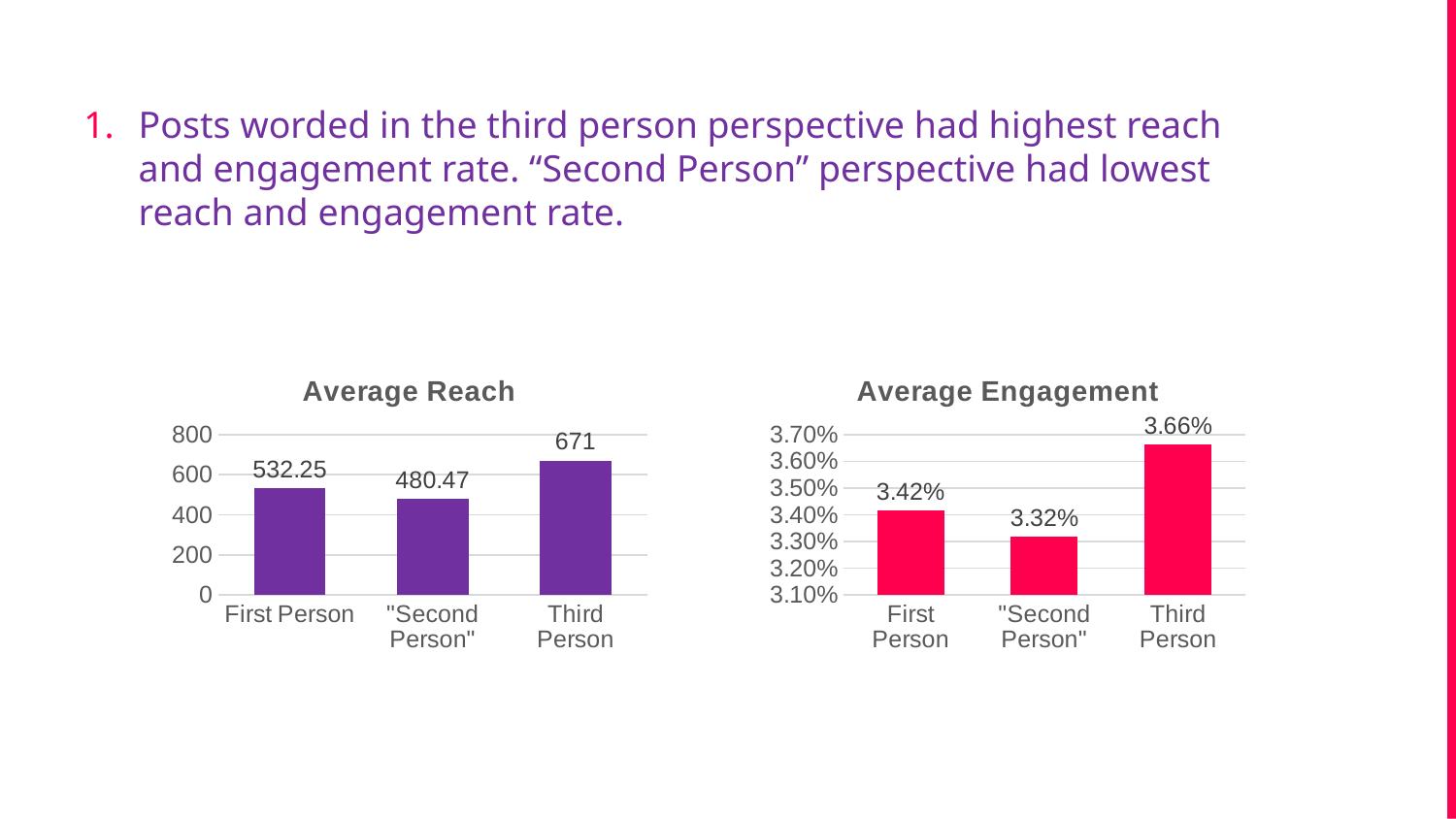
In the Average Engagement chart, what is the value for Third Person? 3.66% In the Average Reach chart, what is the difference between the Third Person and "Second Person" values? 190.53 In the Average Engagement chart, which category has the highest value? Third Person In the Average Engagement chart, what is the difference between the First Person and "Second Person" values? 0.10% In the Average Reach chart, what is the value for First Person? 532.25 How many categories are shown in the Average Engagement chart? 3 In the Average Reach chart, which category has the lowest value? "Second Person" In the Average Reach chart, which is larger, the value for First Person or the value for "Second Person"? First Person What colour are the bars in the Average Engagement chart? Pink In the Average Reach chart, what is the value for Third Person? 671 What kind of chart is the Average Reach chart? Bar chart In the Average Engagement chart, what is the value for "Second Person"? 3.32%